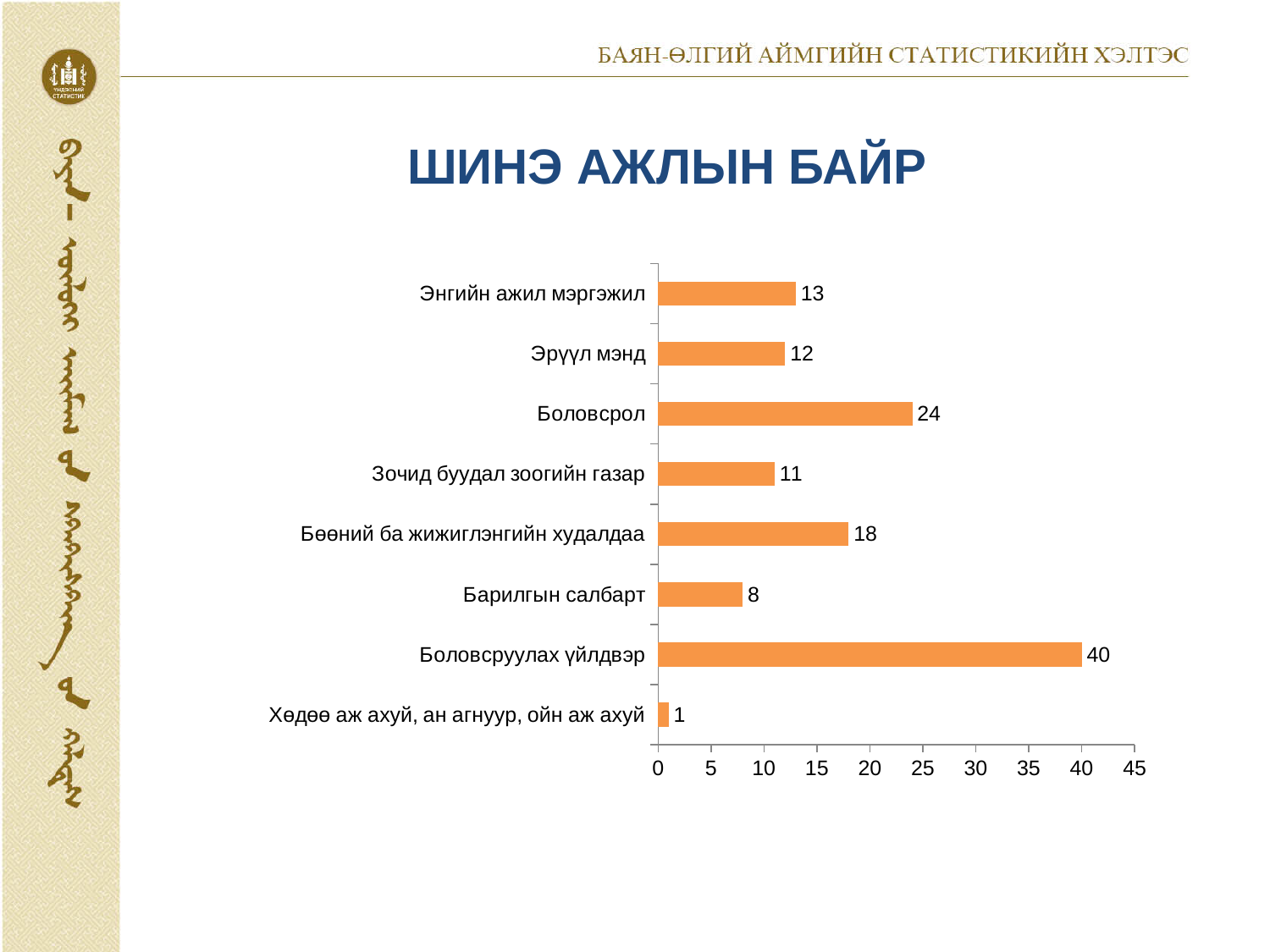
How many categories are shown in the chart? 8 Is the value for Боловсруулах үйлдвэр greater or less than 35? greater What is the value for Бөөний ба жижиглэнгийн худалдаа? 18 What is the difference between the values for Боловсруулах үйлдвэр and Боловсрол? 16 What is the value for Боловсрол? 24 What is the value for Эрүүл мэнд? 12 What is the title of the slide? ШИНЭ АЖЛЫН БАЙР What kind of chart is shown on the slide? bar chart Which is larger, the value for Энгийн ажил мэргэжил or the value for Зочид буудал зоогийн газар? Энгийн ажил мэргэжил Which category has the highest value? Боловсруулах үйлдвэр What is the value for Барилгын салбарт? 8 Which category has the lowest value? Хөдөө аж ахуй, ан агнуур, ойн аж ахуй